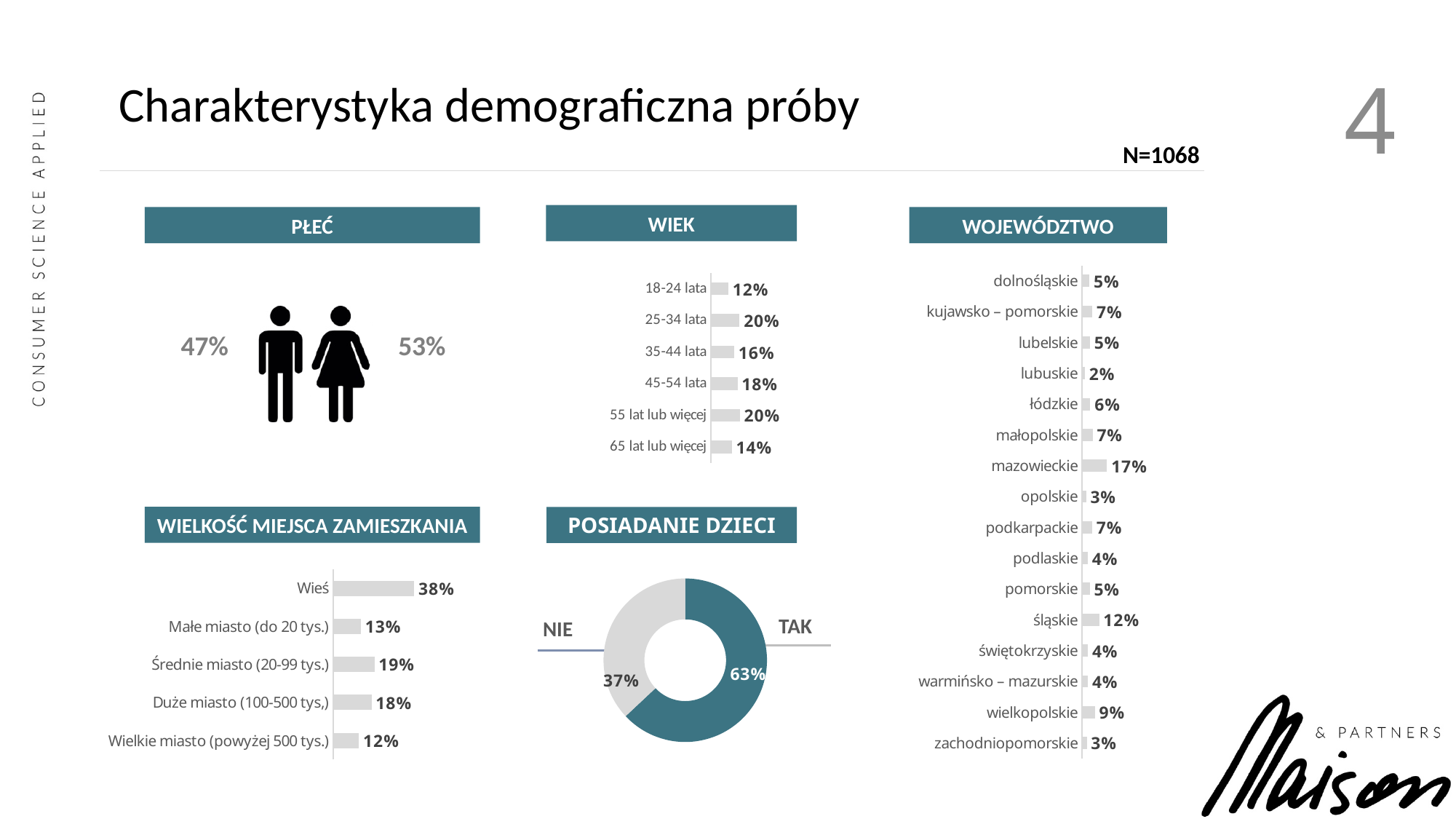
In the WIEK chart, which age group has the lowest value? 18-24 lata In the WIEK chart, what is the value for 25-34 lata? 20% In the WOJEWÓDZTWO chart, which voivodeship has the highest value? mazowieckie In the POSIADANIE DZIECI chart, what share does TAK have? 63% In the WOJEWÓDZTWO chart, how many voivodeships are listed? 16 What kind of chart is the POSIADANIE DZIECI chart? Doughnut chart In the WIEK chart, how many age categories are shown? 6 In the WIELKOŚĆ MIEJSCA ZAMIESZKANIA chart, which category has the highest value? Wieś In the WIELKOŚĆ MIEJSCA ZAMIESZKANIA chart, which is larger: Małe miasto (do 20 tys.) or Duże miasto (100-500 tys.)? Duże miasto (100-500 tys.) In the WIELKOŚĆ MIEJSCA ZAMIESZKANIA chart, what is the value for Średnie miasto (20-99 tys.)? 19% In the WOJEWÓDZTWO chart, what is the value for śląskie? 12% In the WOJEWÓDZTWO chart, what is the difference between mazowieckie and wielkopolskie? 8%